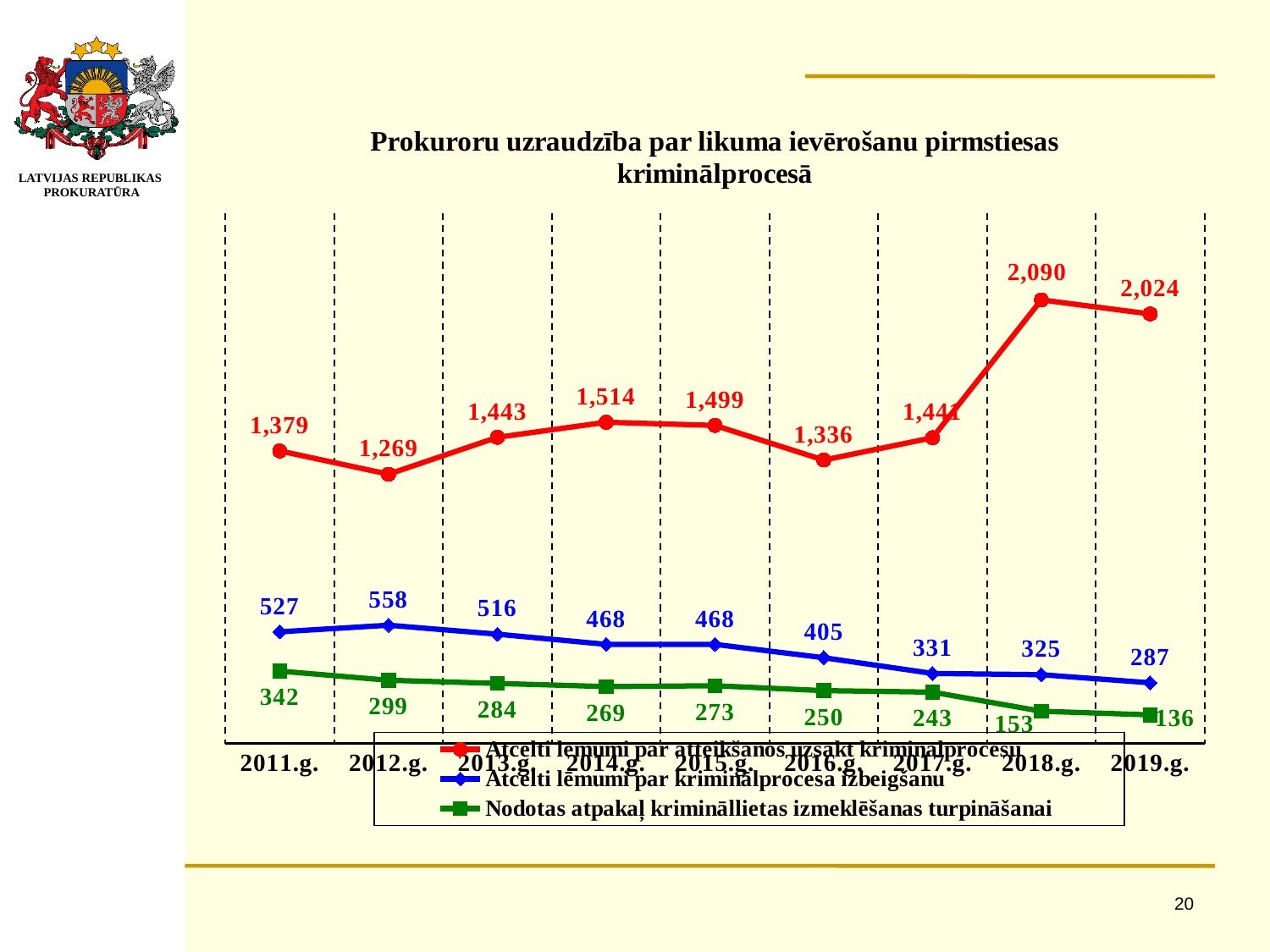
Does the blue series generally rise or fall from 2012.g. to 2019.g.? Fall Which is larger: the blue series value in 2011.g. or in 2019.g.? 2011.g. In which year is the green series at its lowest value? 2019.g. What is the title of the chart? Prokuroru uzraudzība par likuma ievērošanu pirmstiesas kriminālprocesā What is the difference between the red series values in 2018.g. and 2017.g.? 649 In which year does the red series reach its highest value? 2018.g. How many series does the legend list? 3 What is the value of the green series (Nodotas atpakaļ krimināllietas izmeklēšanas turpināšanai) in 2019.g.? 136 What kind of chart is shown on the slide? Line chart How many years are shown on the x axis? 9 What is the value of the red series (Atcelti lēmumi par atteikšanos uzsākt kriminālprocesu) in 2018.g.? 2,090 What is the value of the blue series (Atcelti lēmumi par kriminālprocesa izbeigšanu) in 2012.g.? 558